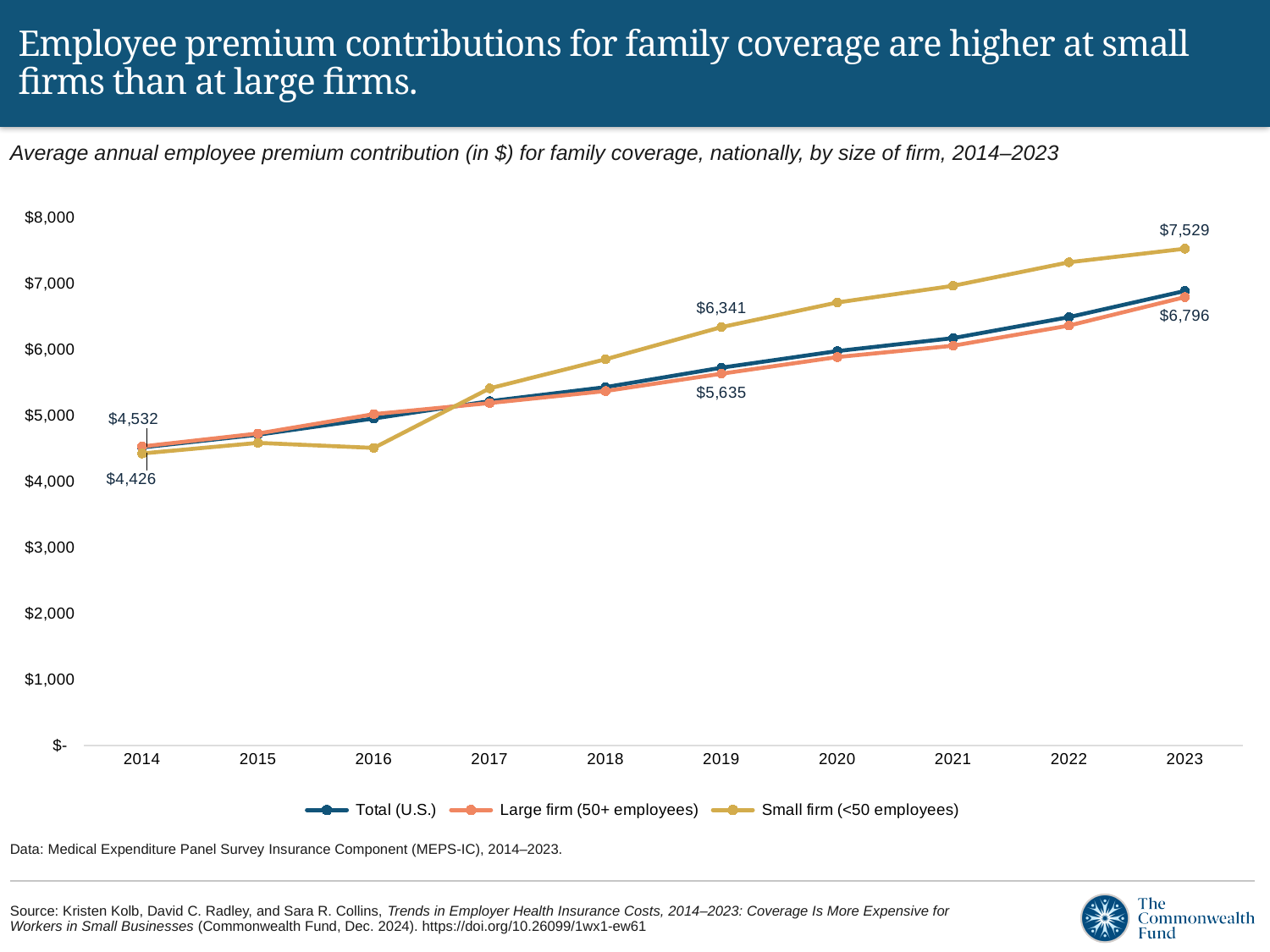
In 2014, which had the higher employee premium contribution: large firms (50+ employees) or small firms (<50 employees)? Large firms (50+ employees) What was the average annual employee premium contribution for family coverage at small firms (<50 employees) in 2023? $7,529 What is the difference between the small firm and large firm employee premium contributions in 2019? $706 Does the small firm (<50 employees) line rise or fall from 2016 to 2023? Rises Is the value for Total (U.S.) in 2023 greater or less than $6,000? greater What was the average annual employee premium contribution for family coverage at large firms (50+ employees) in 2023? $6,796 What kind of chart is shown on the slide? Line chart What was the employee premium contribution at large firms (50+ employees) in 2014? $4,532 What was the employee premium contribution at small firms (<50 employees) in 2019? $6,341 What is the difference between the small firm and large firm employee premium contributions in 2023? $733 How many series does the legend list? 3 How many years are plotted along the x axis? 10